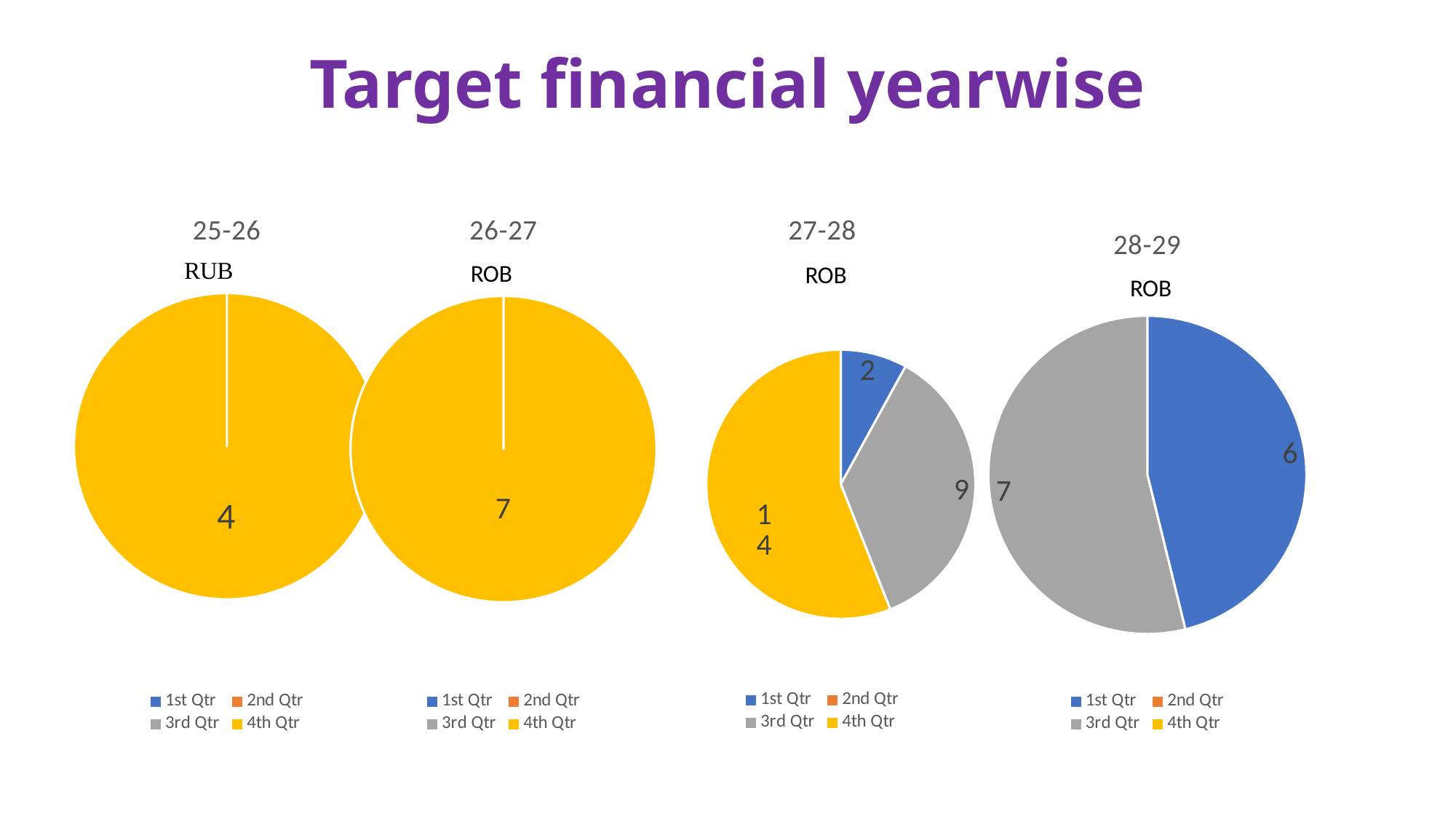
In the 27-28 ROB pie chart, what is the value for 1st Qtr? 2 What type of chart is used for the 26-27 ROB data? Pie chart In the 28-29 ROB pie chart, what is the value for 1st Qtr? 6 In the 27-28 ROB pie chart, which is larger, the 3rd Qtr slice or the 1st Qtr slice? 3rd Qtr In the 27-28 ROB pie chart, which quarter has the smallest slice? 1st Qtr How many slices does the 28-29 ROB pie chart have? 2 In the 27-28 ROB pie chart, what share of the total does the 1st Qtr slice represent? 8% In the 26-27 ROB pie chart, what value is shown on the slice? 7 In the 28-29 ROB pie chart, what is the difference between the 3rd Qtr and 1st Qtr values? 1 In the 27-28 ROB pie chart, which quarter has the largest slice? 4th Qtr In the 27-28 ROB pie chart, what is the value for 3rd Qtr? 9 In the 25-26 RUB pie chart, what value is shown on the slice? 4